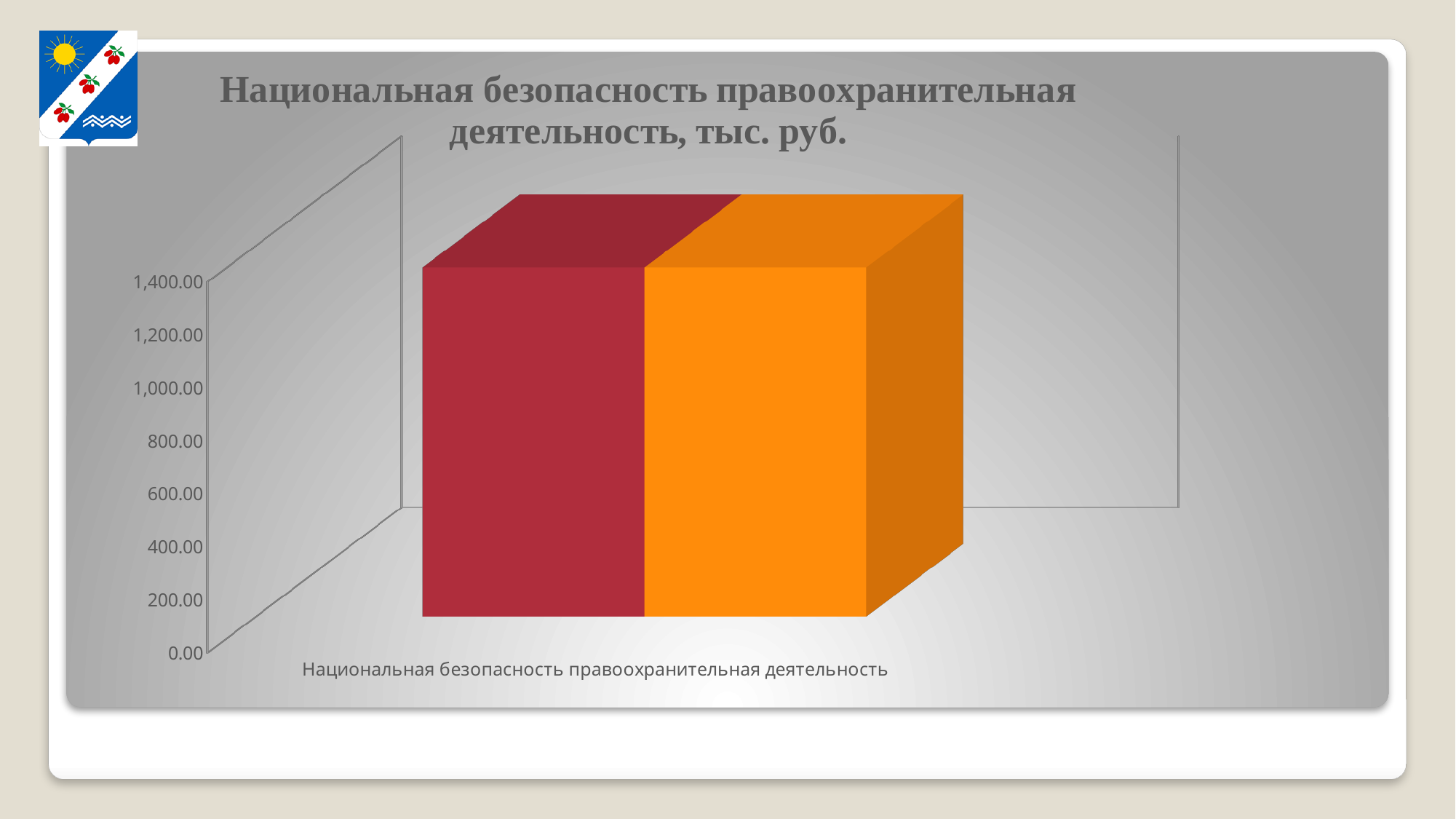
Is the value of the red bar greater or less than 600.00? greater What is the title of the chart? Национальная безопасность правоохранительная деятельность, тыс. руб. What kind of chart is shown on the slide? bar chart Is the value of the orange bar greater or less than 800.00? greater How many bars are plotted in the chart? 2 What is the category label shown on the x axis? Национальная безопасность правоохранительная деятельность What is the lowest tick value shown on the vertical axis? 0.00 How many categories are shown on the x axis of the chart? 1 Is the value of the red bar greater or less than 1,000.00? greater What is the highest tick value shown on the vertical axis? 1,400.00